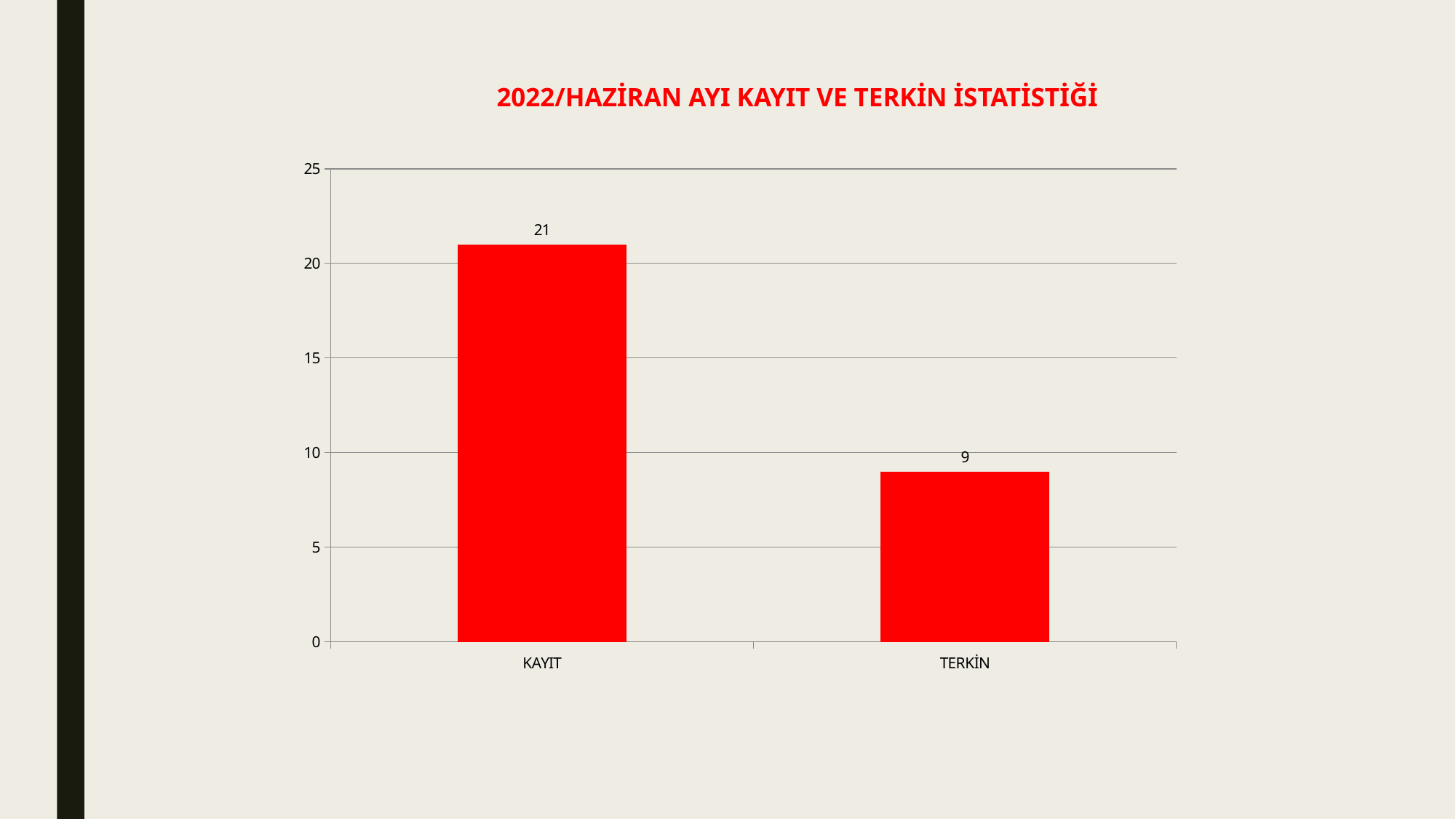
What colour are the bars in the chart? red Which category has the lowest value? TERKİN What is the difference between the values for KAYIT and TERKİN? 12 How many categories are shown on the x axis? 2 What is the title of the chart? 2022/HAZİRAN AYI KAYIT VE TERKİN İSTATİSTİĞİ What is the value for KAYIT? 21 Which is larger, the value for KAYIT or the value for TERKİN? KAYIT Is the value for TERKİN greater or less than 10? less What kind of chart is shown on the slide? bar chart Is the value for KAYIT greater or less than 20? greater What is the value for TERKİN? 9 Which category has the highest value? KAYIT